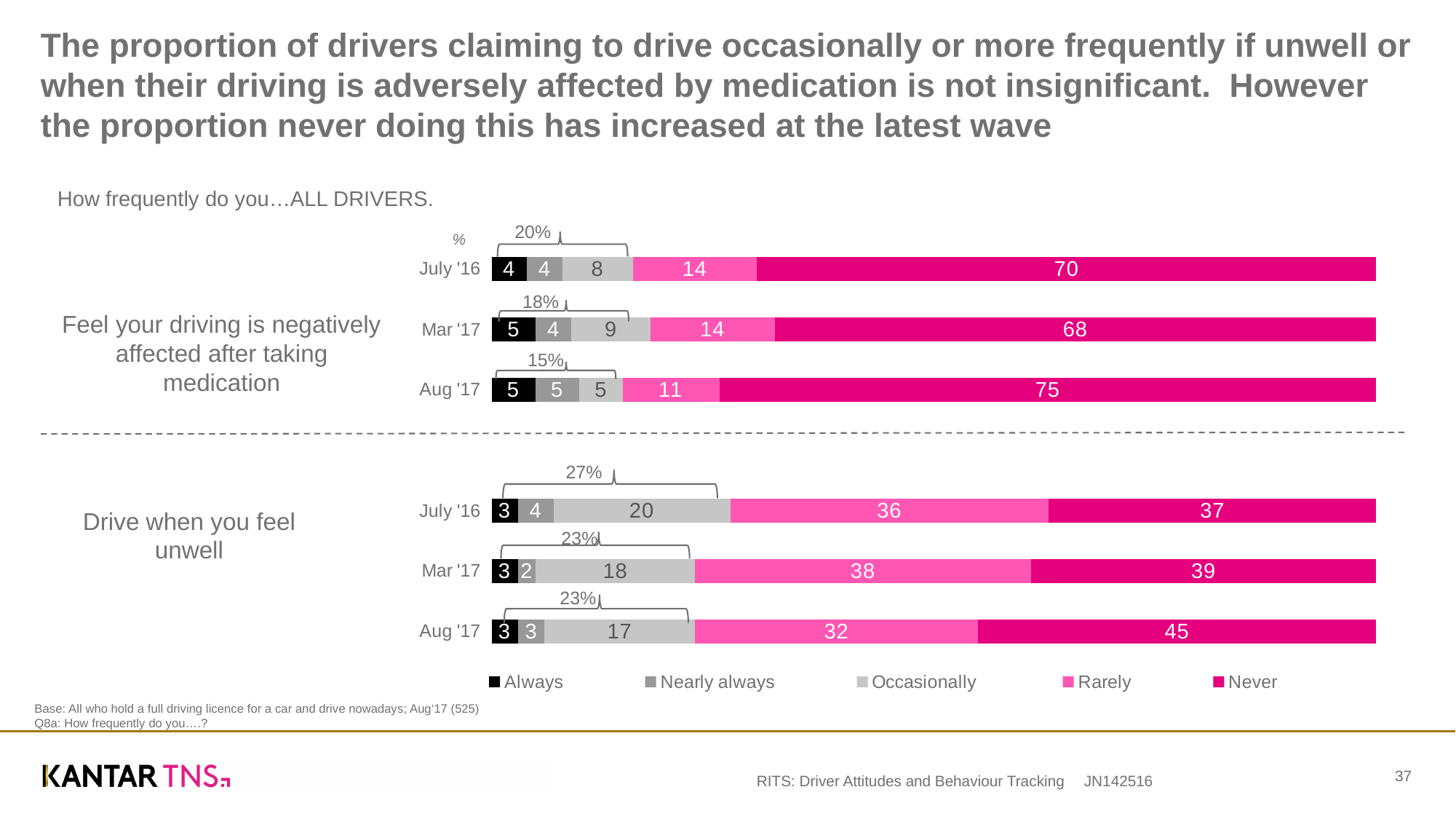
In the 'Feel your driving is negatively affected after taking medication' chart, which wave has the highest Never value? Aug '17 In the 'Drive when you feel unwell' chart, what is the Occasionally value for July '16? 20 In the 'Feel your driving is negatively affected after taking medication' chart, what combined percentage is shown by the bracket above the Aug '17 bar? 15% In the 'Drive when you feel unwell' chart, what is the Rarely value for Mar '17? 38 In the 'Drive when you feel unwell' chart, what is the difference between the Never values for Aug '17 and Mar '17? 6 In the 'Feel your driving is negatively affected after taking medication' chart, is the Never value larger for July '16 or Mar '17? July '16 What kind of chart is used on this slide? Stacked bar chart In the 'Drive when you feel unwell' chart, does the Never value rise or fall from July '16 to Aug '17? Rise How many series does the legend list? 5 In the 'Drive when you feel unwell' chart, which wave has the lowest Rarely value? Aug '17 In the 'Feel your driving is negatively affected after taking medication' chart, what is the Never value for Aug '17? 75 How many waves (bars) are shown in the 'Drive when you feel unwell' chart? 3